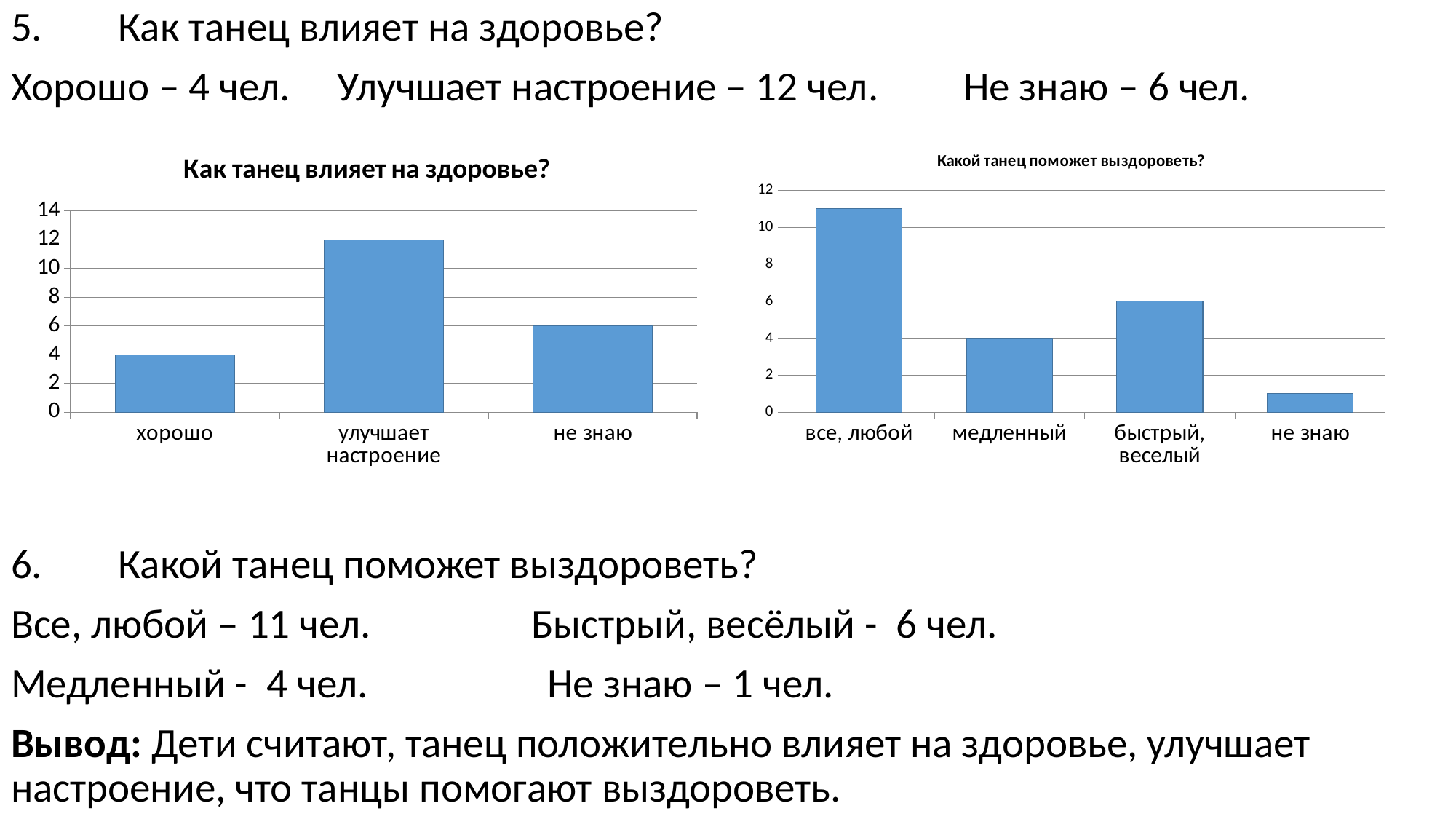
In the chart titled "Как танец влияет на здоровье?", which category has the highest value? улучшает настроение In the chart titled "Какой танец поможет выздороветь?", which category has the lowest value? не знаю In the chart titled "Как танец влияет на здоровье?", how many categories are shown? 3 What kind of chart is the chart titled "Какой танец поможет выздороветь?"? bar chart In the chart titled "Как танец влияет на здоровье?", which category has the lowest value? хорошо In the chart titled "Какой танец поможет выздороветь?", what is the value for "быстрый, веселый"? 6 In the chart titled "Как танец влияет на здоровье?", what is the difference between the values for "улучшает настроение" and "не знаю"? 6 In the chart titled "Как танец влияет на здоровье?", what is the value for "улучшает настроение"? 12 In the chart titled "Какой танец поможет выздороветь?", which is larger, the value for "медленный" or the value for "быстрый, веселый"? быстрый, веселый In the chart titled "Как танец влияет на здоровье?", what is the value for "хорошо"? 4 In the chart titled "Какой танец поможет выздороветь?", is the value for "все, любой" greater or less than 10? greater In the chart titled "Какой танец поможет выздороветь?", what is the value for "медленный"? 4